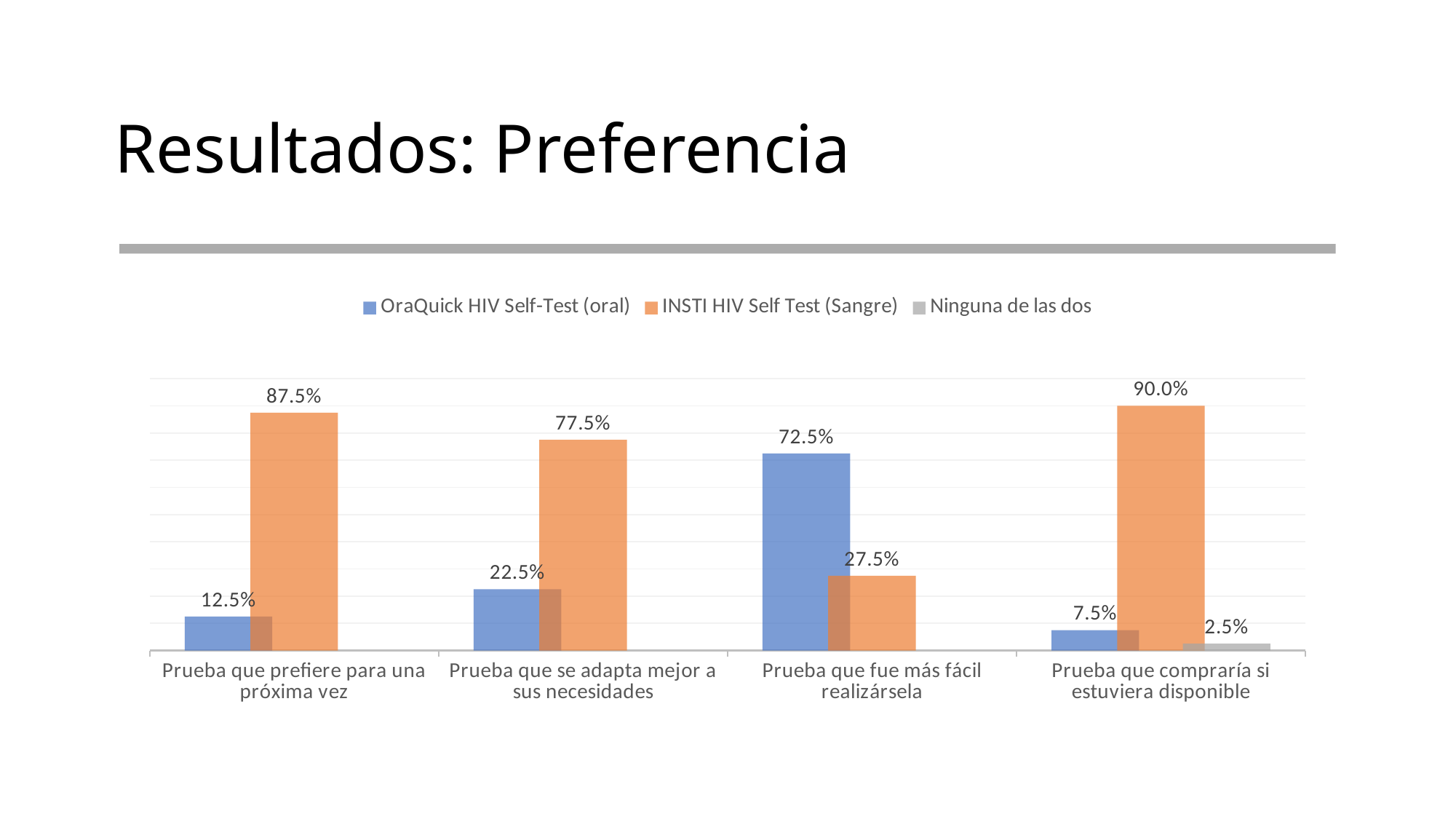
What is the value for INSTI HIV Self Test (Sangre) in the category 'Prueba que prefiere para una próxima vez'? 87.5% What is the title of the slide containing the chart? Resultados: Preferencia How many categories are shown on the x axis? 4 What is the value for Ninguna de las dos in the category 'Prueba que compraría si estuviera disponible'? 2.5% In which category does OraQuick HIV Self-Test (oral) have its lowest value? Prueba que compraría si estuviera disponible In which category does INSTI HIV Self Test (Sangre) have its highest value? Prueba que compraría si estuviera disponible What is the difference between INSTI HIV Self Test (Sangre) and OraQuick HIV Self-Test (oral) in the category 'Prueba que prefiere para una próxima vez'? 75.0% What is the value for OraQuick HIV Self-Test (oral) in the category 'Prueba que se adapta mejor a sus necesidades'? 22.5% What type of chart is shown on the slide? bar chart In the category 'Prueba que fue más fácil realizársela', which series has the larger value, OraQuick HIV Self-Test (oral) or INSTI HIV Self Test (Sangre)? OraQuick HIV Self-Test (oral) What is the value for OraQuick HIV Self-Test (oral) in the category 'Prueba que fue más fácil realizársela'? 72.5% How many series does the legend list? 3